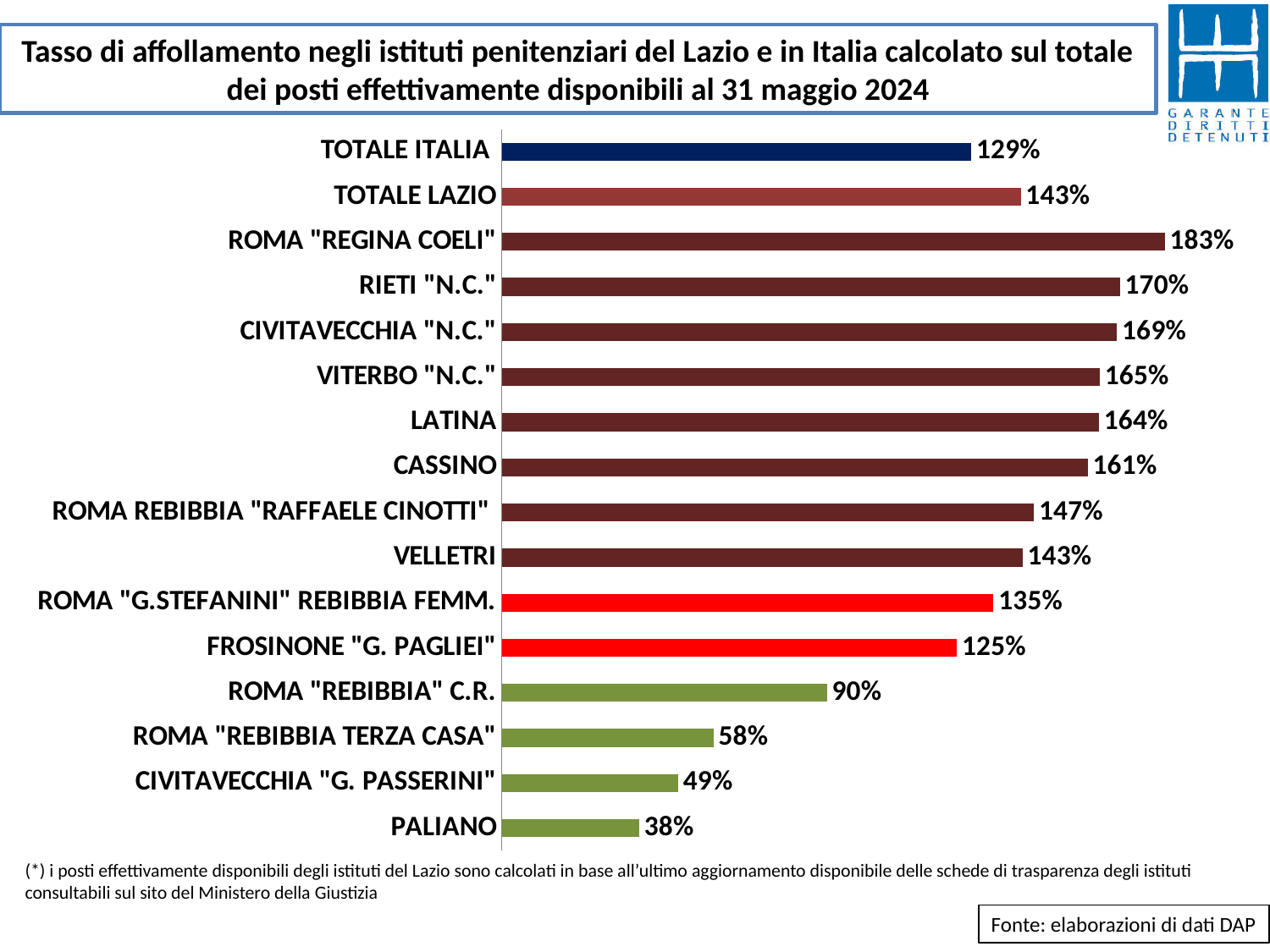
Which is larger, the value for LATINA or the value for CASSINO? LATINA Which category has the highest value? ROMA "REGINA COELI" What kind of chart is shown on the slide? Bar chart What is the value for ROMA "REGINA COELI"? 183% Which category has the lowest value? PALIANO What is the value for CIVITAVECCHIA "G. PASSERINI"? 49% What is the source stated at the bottom right of the slide? Fonte: elaborazioni di dati DAP What is the difference between RIETI "N.C." and CIVITAVECCHIA "N.C."? 1% What is the difference between TOTALE LAZIO and TOTALE ITALIA? 14% What is the value for PALIANO? 38% How many categories are shown in the chart? 16 What is the value for TOTALE ITALIA? 129%